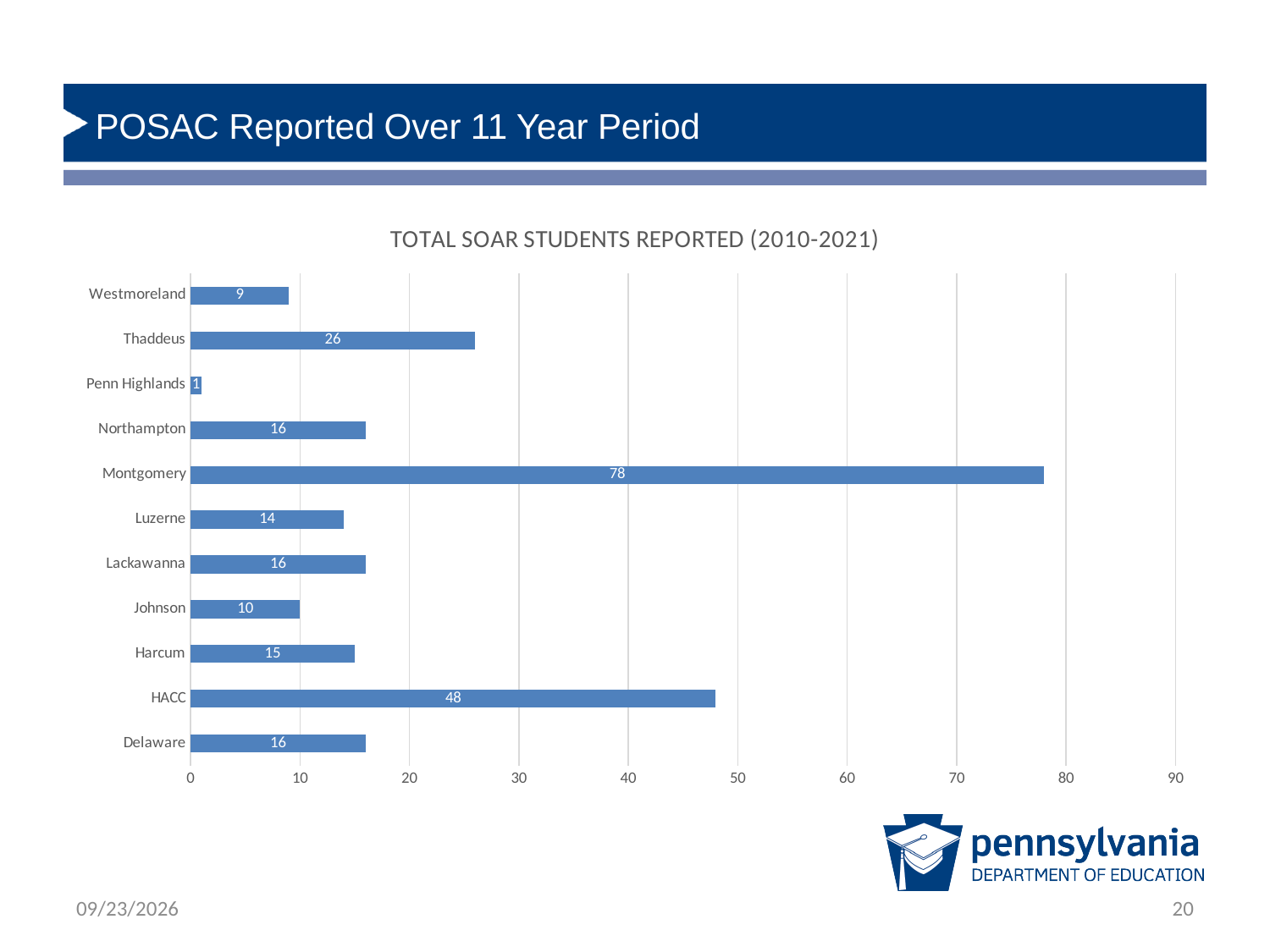
Is the value for HACC greater or less than 40? greater Which is larger, the value for Thaddeus or the value for Northampton? Thaddeus Which category has the lowest value? Penn Highlands Which category has the highest value? Montgomery How many categories are shown in the chart? 11 What is the value for Montgomery? 78 What is the value for Thaddeus? 26 What is the value for Penn Highlands? 1 What is the value for HACC? 48 What is the title of the chart? TOTAL SOAR STUDENTS REPORTED (2010-2021) What kind of chart is shown on the slide? bar chart What is the difference between the values for Montgomery and HACC? 30